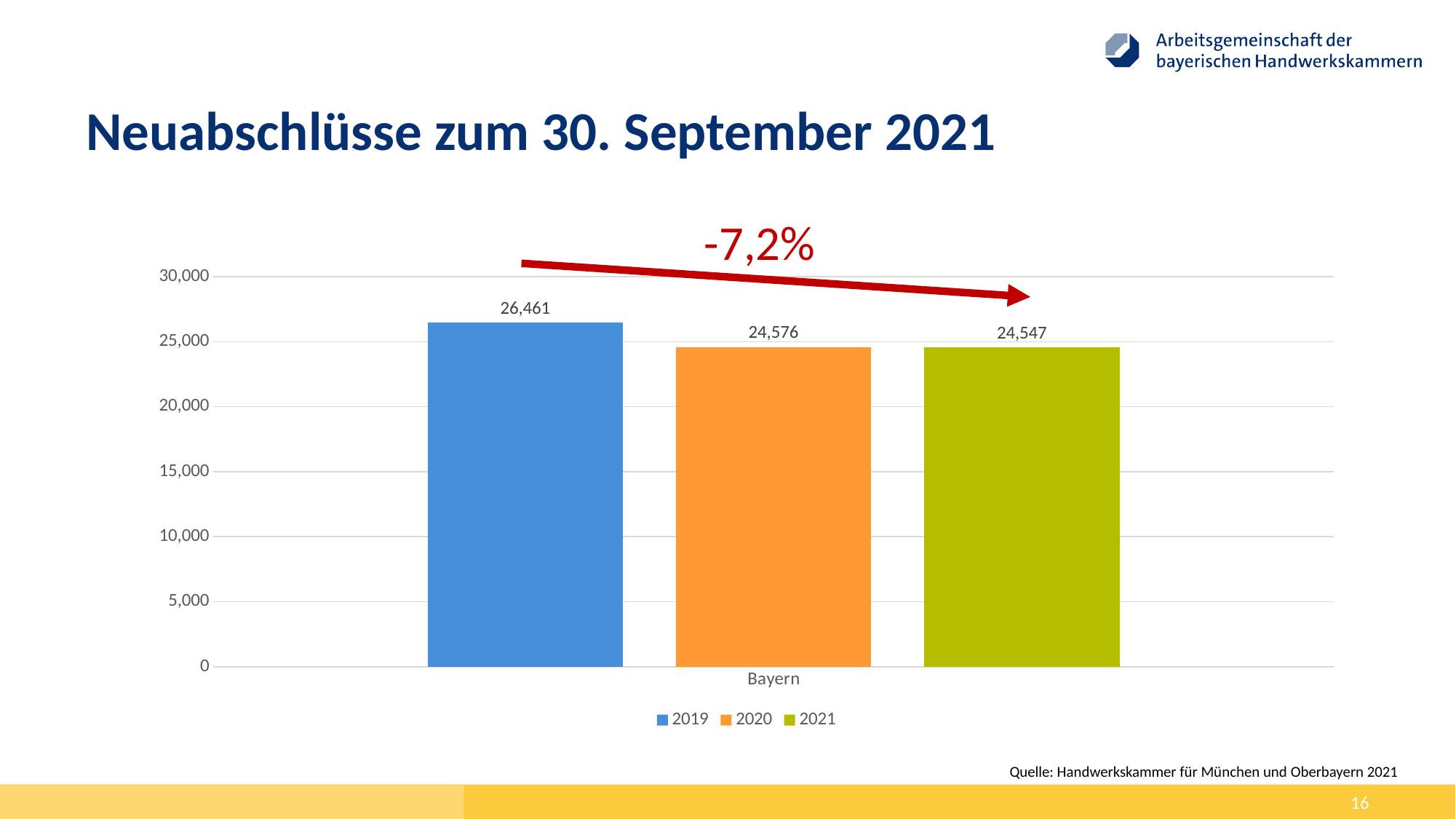
Which year has the highest value in the chart? 2019 What is the value for 2019 in the chart? 26,461 What is the value for 2021 in the chart? 24,547 What is the difference between the 2020 value and the 2021 value? 29 Which year has the lowest value in the chart? 2021 What kind of chart is shown on the slide? bar chart Which is larger, the value for 2019 or the value for 2021? 2019 Is the value for 2021 greater or less than 25,000? less How many series does the legend list? 3 What is the value for 2020 in the chart? 24,576 What is the difference between the 2019 value and the 2020 value? 1,885 What percentage change is annotated above the bars in red? -7,2%